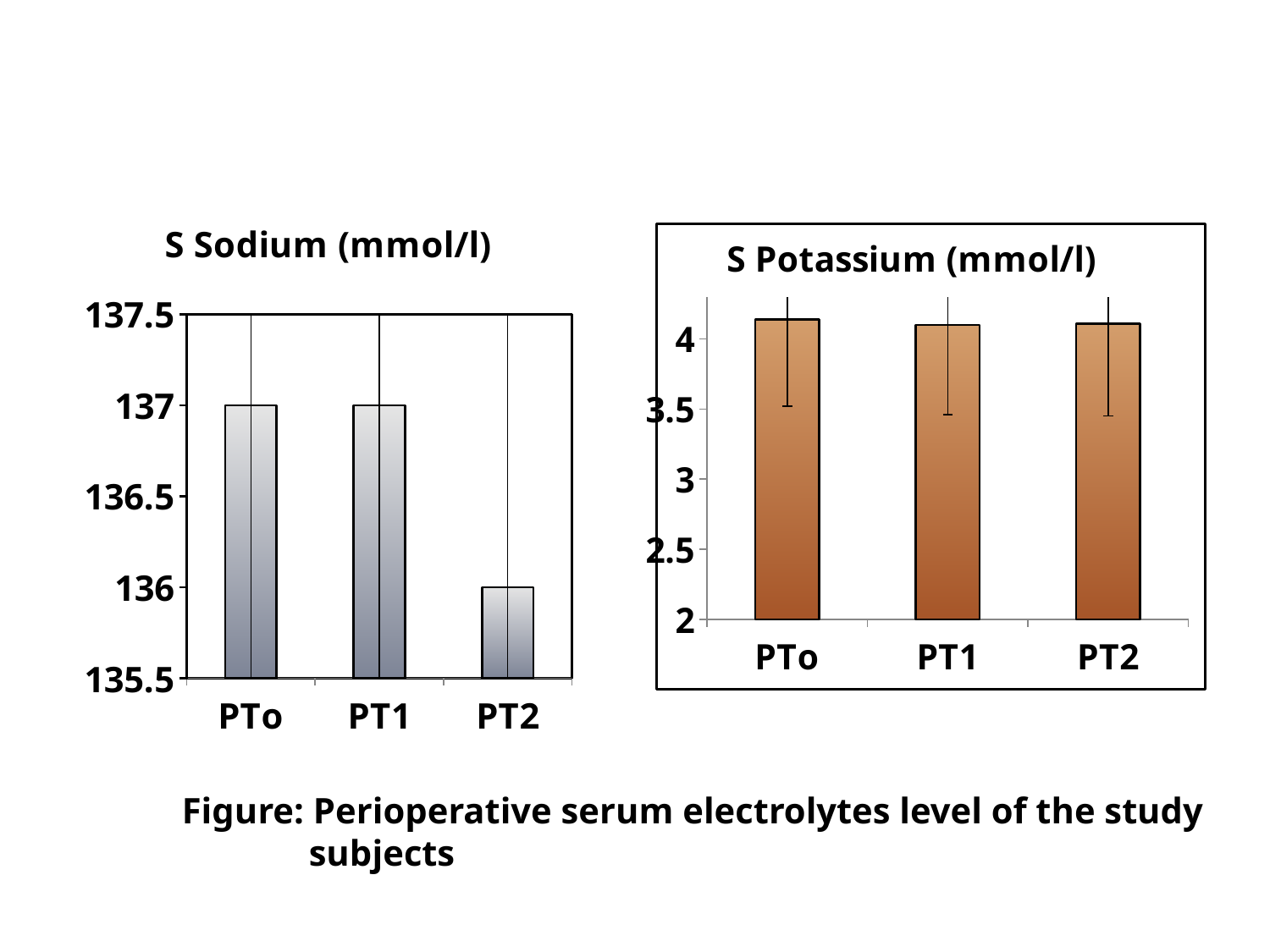
What kind of chart is the S Sodium (mmol/l) chart? Bar chart In the S Sodium (mmol/l) chart, what is the value for PT2? 136 In the S Sodium (mmol/l) chart, do the values rise or fall from PTo to PT2? Fall In the S Potassium (mmol/l) chart, is the value for PT2 greater or less than 3? greater In the S Potassium (mmol/l) chart, is the value for PTo greater or less than 3.5? greater In the S Sodium (mmol/l) chart, which is larger, the value for PTo or the value for PT2? PTo What colour are the bars in the S Potassium (mmol/l) chart? Orange In the S Sodium (mmol/l) chart, what is the value for PTo? 137 In the S Sodium (mmol/l) chart, which category has the lowest value? PT2 In the S Sodium (mmol/l) chart, what is the difference between the values for PT1 and PT2? 1 How many categories are shown in the S Potassium (mmol/l) chart? 3 What is the title of the chart on the right side of the slide? S Potassium (mmol/l)